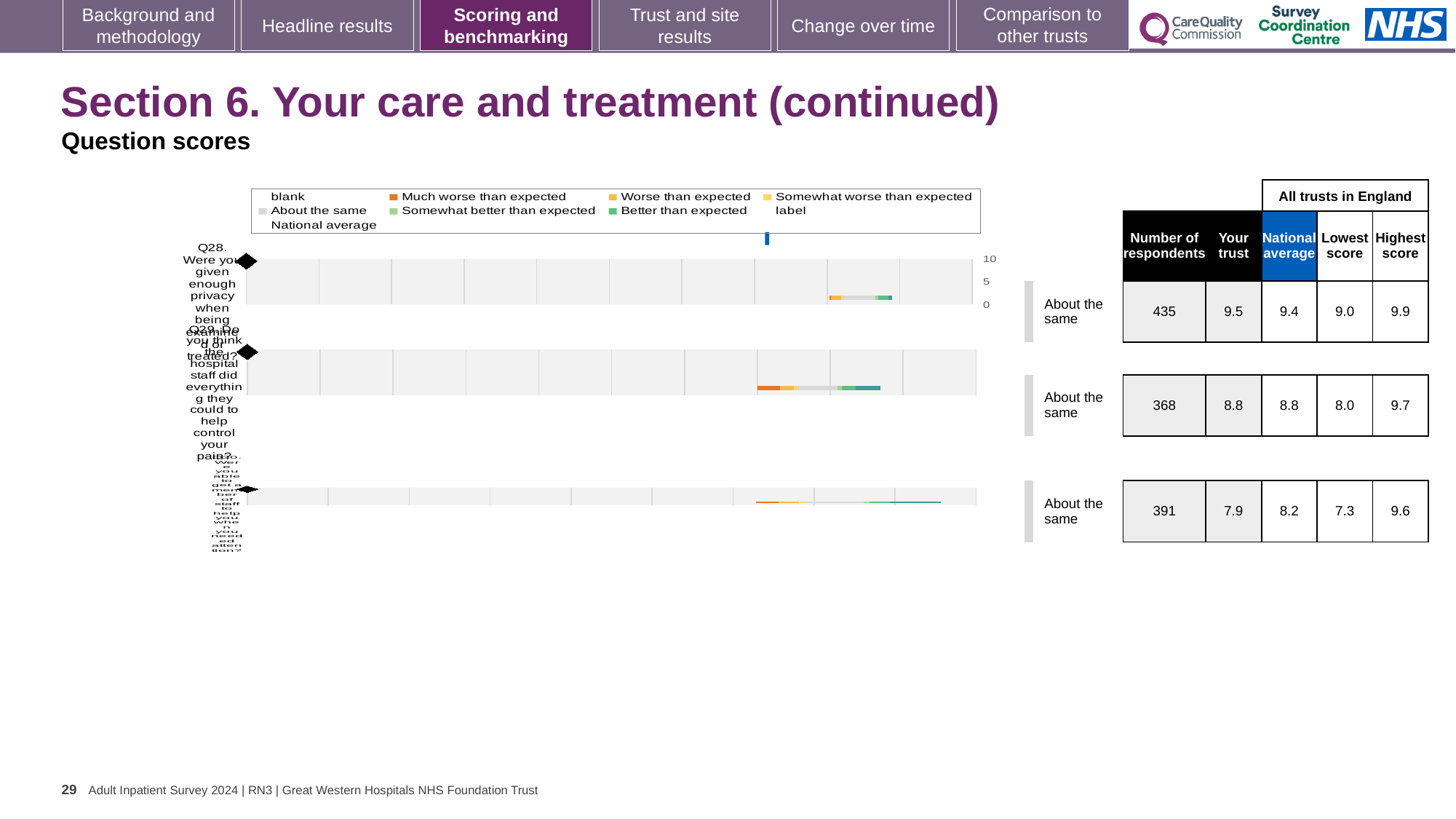
What is the national average score for Q29 (Do you think the hospital staff did everything they could to help control your pain?)? 8.8 How many respondents answered Q30 (Were you able to get a member of staff to help you when you needed attention?)? 391 What kind of chart is used to show the question scores? Bar chart What is the 'Your trust' score for Q28 (Were you given enough privacy when being examined or treated?)? 9.5 What benchmark category is shown for Q29? About the same How many questions are plotted on the chart? 3 What is the highest score among all trusts in England for Q28? 9.9 Which question has the highest 'Your trust' score? Q28 Which question has the lowest 'Your trust' score? Q30 What is the lowest score among all trusts in England for Q30? 7.3 For Q28, is the 'Your trust' score or the national average higher? Your trust What is the difference between the 'Your trust' score and the national average for Q30? 0.3